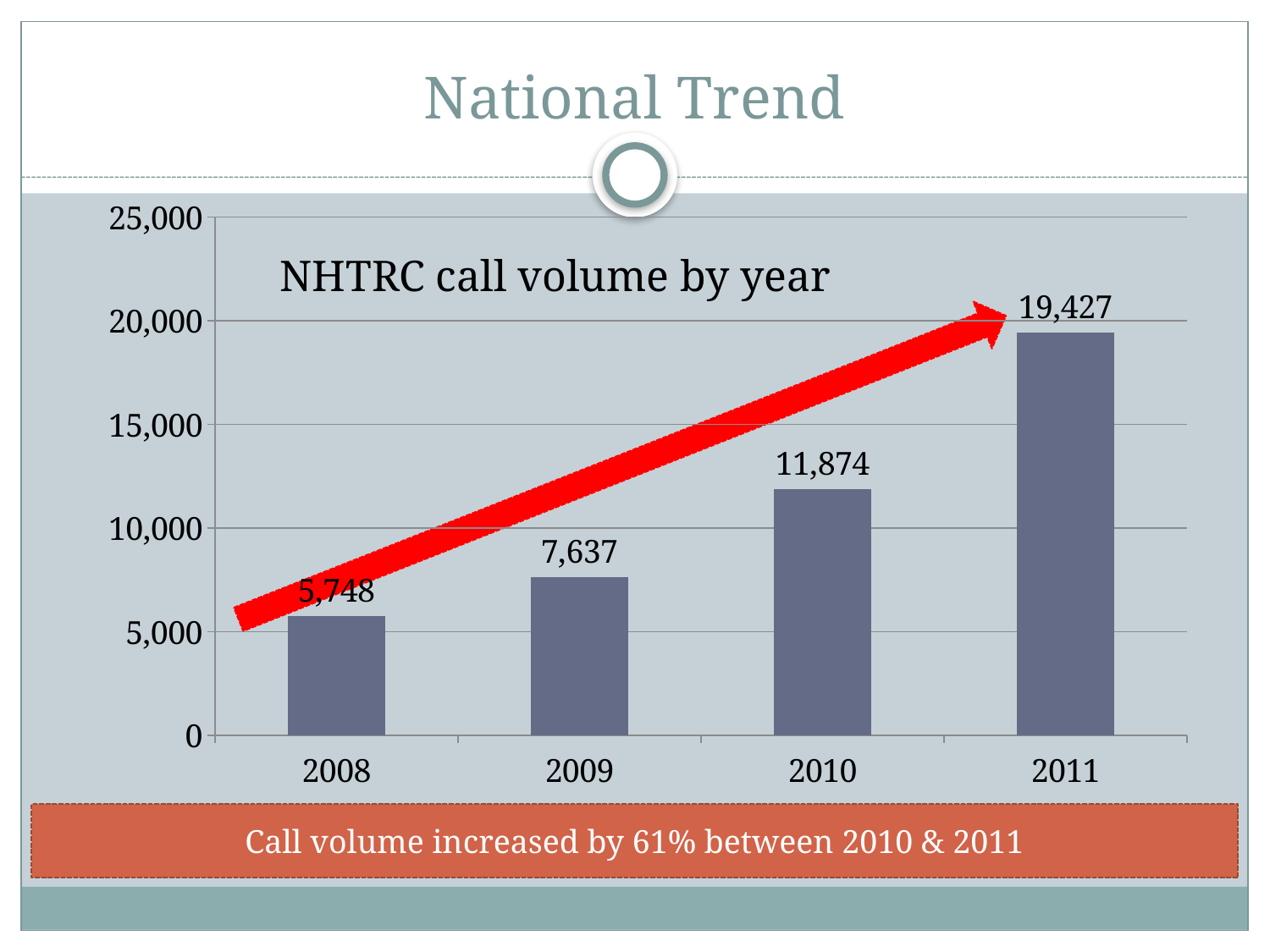
Which year has the lowest call volume? 2008 What is the NHTRC call volume for 2009? 7,637 What is the difference in call volume between 2011 and 2010? 7,553 What is the difference in call volume between 2009 and 2008? 1,889 How many years are shown in the chart? 4 What is the NHTRC call volume for 2011? 19,427 What is the NHTRC call volume for 2010? 11,874 Does the call volume rise or fall from 2008 to 2011? Rise What is the NHTRC call volume for 2008? 5,748 What kind of chart is shown on the slide? Bar chart Which year had a larger call volume, 2009 or 2010? 2010 Which year has the highest call volume? 2011